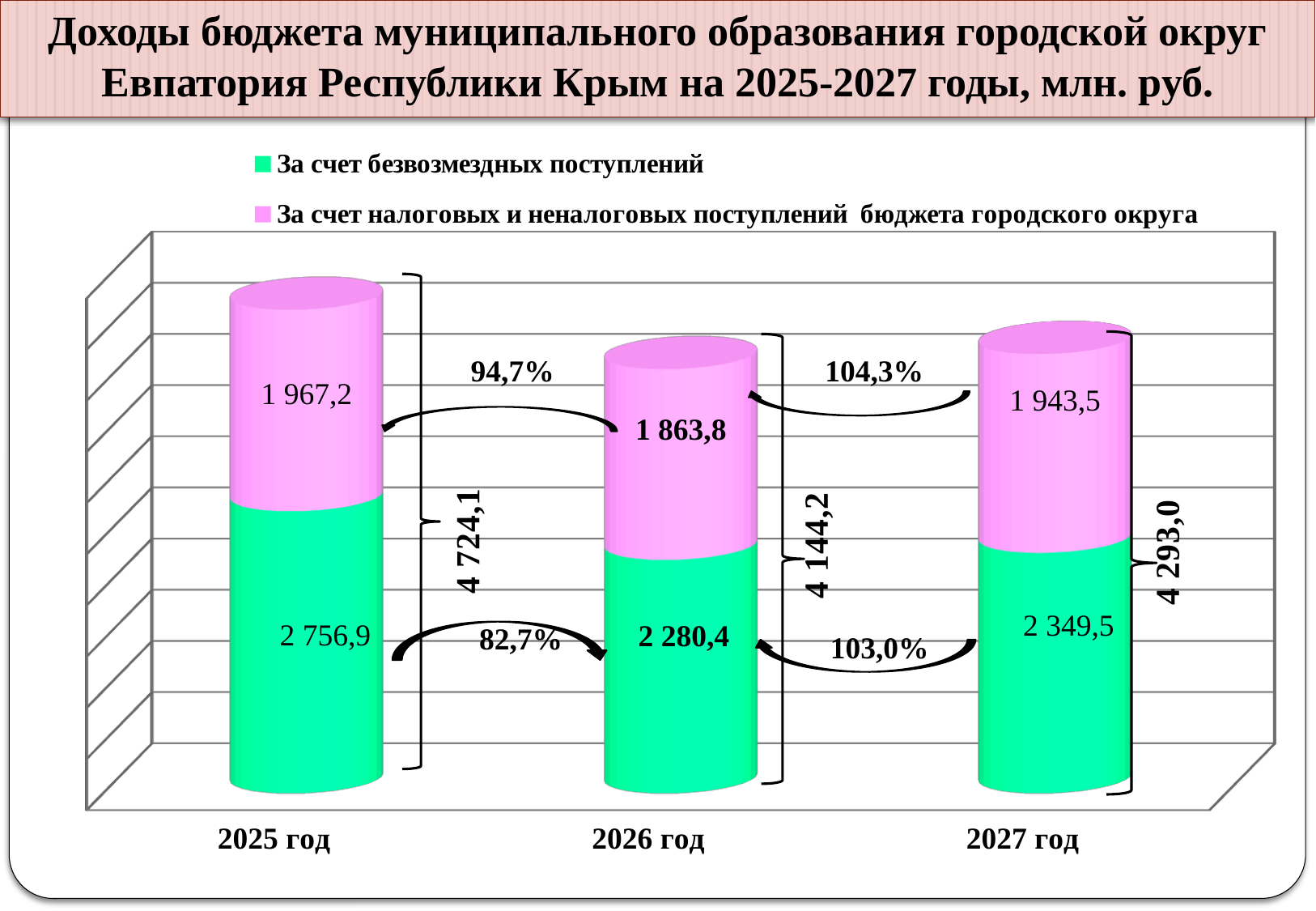
What kind of chart is shown on the slide? Stacked bar chart What is the difference between the "За счет безвозмездных поступлений" values for 2025 год and 2026 год? 476,5 What percentage is shown on the arrow between the "За счет безвозмездных поступлений" values for 2026 год and 2027 год? 103,0% How many series does the legend list? 2 Which is larger: the "За счет налоговых и неналоговых поступлений бюджета городского округа" value in 2025 год or in 2027 год? 2025 год What is the value for "За счет налоговых и неналоговых поступлений бюджета городского округа" in 2027 год? 1 943,5 What is the value for "За счет безвозмездных поступлений" in 2026 год? 2 280,4 Which year has the highest total budget revenue? 2025 год What is the value for "За счет безвозмездных поступлений" in 2025 год? 2 756,9 How many years are shown on the x axis? 3 Which year has the lowest value for "За счет налоговых и неналоговых поступлений бюджета городского округа"? 2026 год What is the total of the stacked bar for 2026 год? 4 144,2